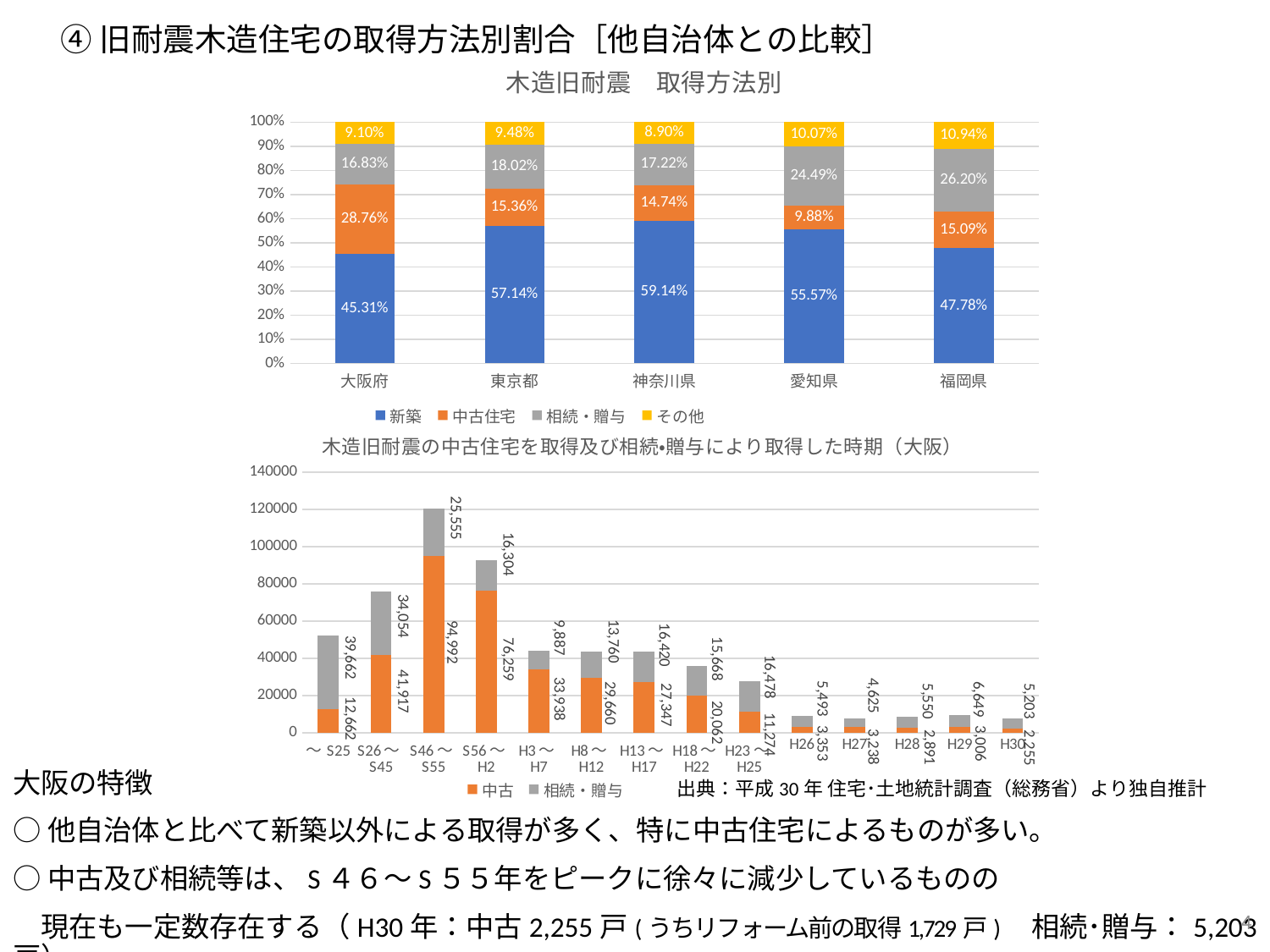
In the top chart (木造旧耐震 取得方法別), what is the 中古住宅 share for 愛知県? 9.88% In the top chart (木造旧耐震 取得方法別), what is the difference between the 中古住宅 share of 大阪府 and that of 東京都? 13.40% In the top chart (木造旧耐震 取得方法別), which is larger: the 相続・贈与 share of 福岡県 or of 愛知県? 福岡県 In the top chart (木造旧耐震 取得方法別), which prefecture has the highest 新築 share? 神奈川県 In the top chart (木造旧耐震 取得方法別), what is the 新築 share for 大阪府? 45.31% In the bottom chart (取得した時期（大阪）), what is the 相続・贈与 value for H30? 5,203 In the bottom chart (取得した時期（大阪）), how many categories are shown on the x axis? 14 In the bottom chart (取得した時期（大阪）), what is the total of the stacked bar for S46〜S55? 120,547 In the top chart (木造旧耐震 取得方法別), which prefecture has the lowest 中古住宅 share? 愛知県 In the top chart (木造旧耐震 取得方法別), how many series does the legend list? 4 What kind of chart is the bottom chart (取得した時期（大阪）)? Stacked bar chart In the bottom chart (取得した時期（大阪）), what is the 中古 value for S46〜S55? 94,992